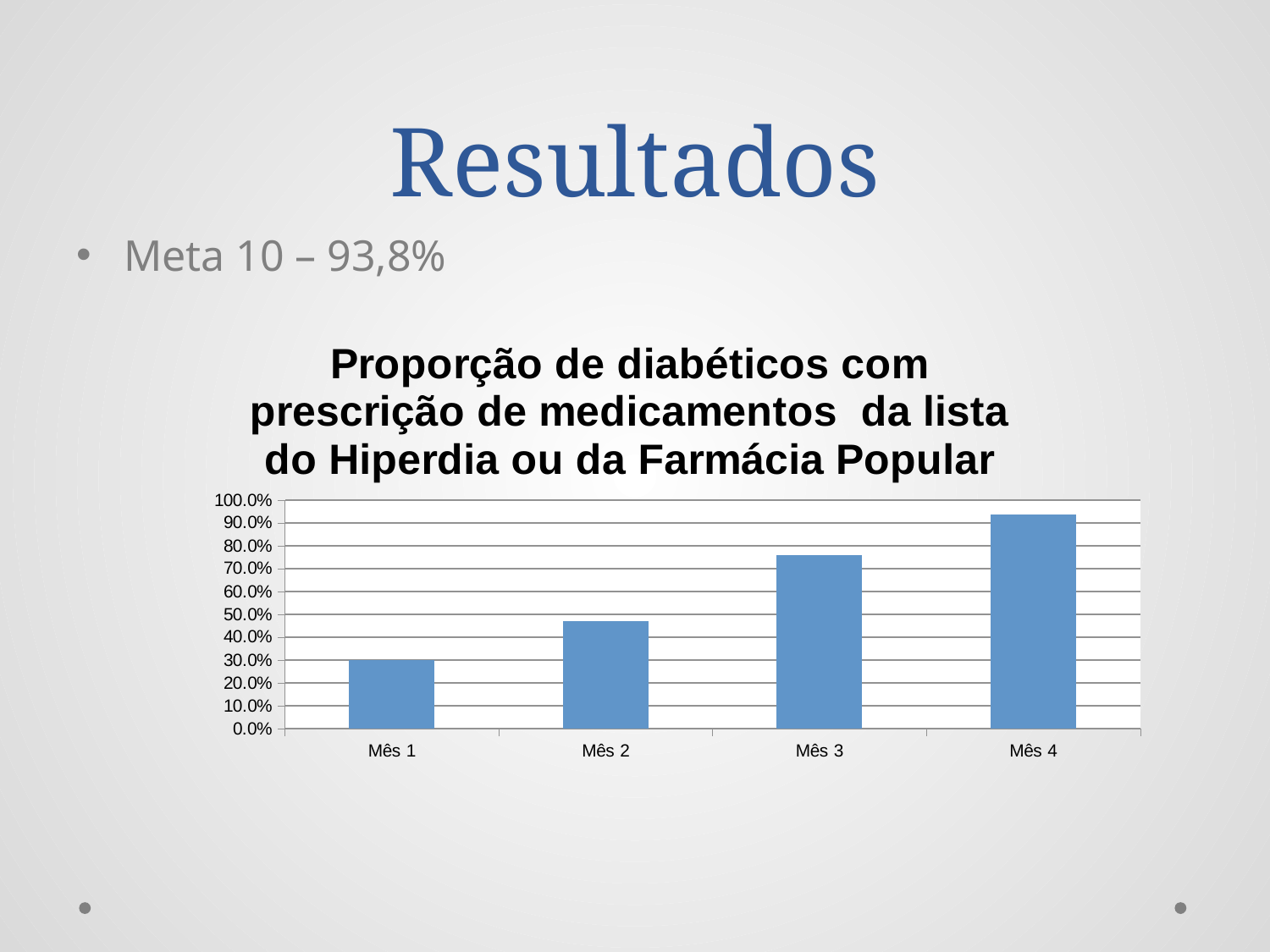
Is the value for Mês 4 greater or less than 90.0%? greater Which month has the lowest bar in the chart? Mês 1 Do the values rise or fall from Mês 1 to Mês 4? rise Is the value for Mês 1 greater or less than 40.0%? less What kind of chart is shown on the slide? bar chart What is the title of the chart? Proporção de diabéticos com prescrição de medicamentos da lista do Hiperdia ou da Farmácia Popular What is the maximum value shown on the y axis of the chart? 100.0% Which is larger, the value for Mês 2 or the value for Mês 3? Mês 3 Which month has the highest bar in the chart? Mês 4 Is the value for Mês 3 greater or less than 70.0%? greater How many categories (months) are shown on the x axis of the chart? 4